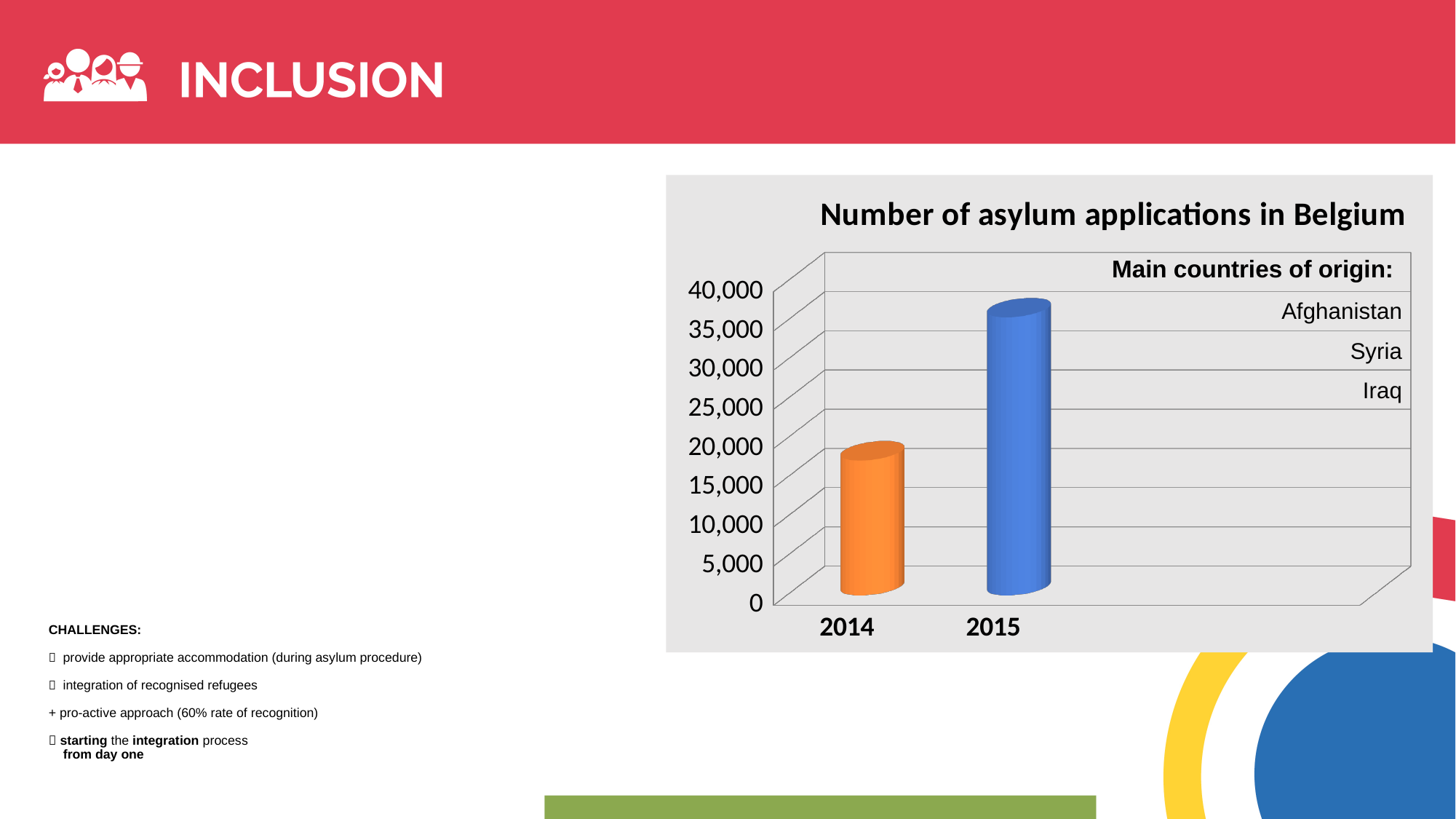
Is the value for 2015 greater or less than 30,000? greater Which three main countries of origin are listed on the chart? Afghanistan, Syria, Iraq What is the title of the chart? Number of asylum applications in Belgium Is the value for 2014 greater or less than 10,000? greater Which year has the higher number of asylum applications? 2015 Is the value for 2015 greater or less than 40,000? less What kind of chart is shown on the slide? bar chart Which year has the lower number of asylum applications? 2014 Do the values rise or fall from 2014 to 2015? rise How many years are plotted on the chart? 2 Is the value for 2015 larger or smaller than the value for 2014? larger